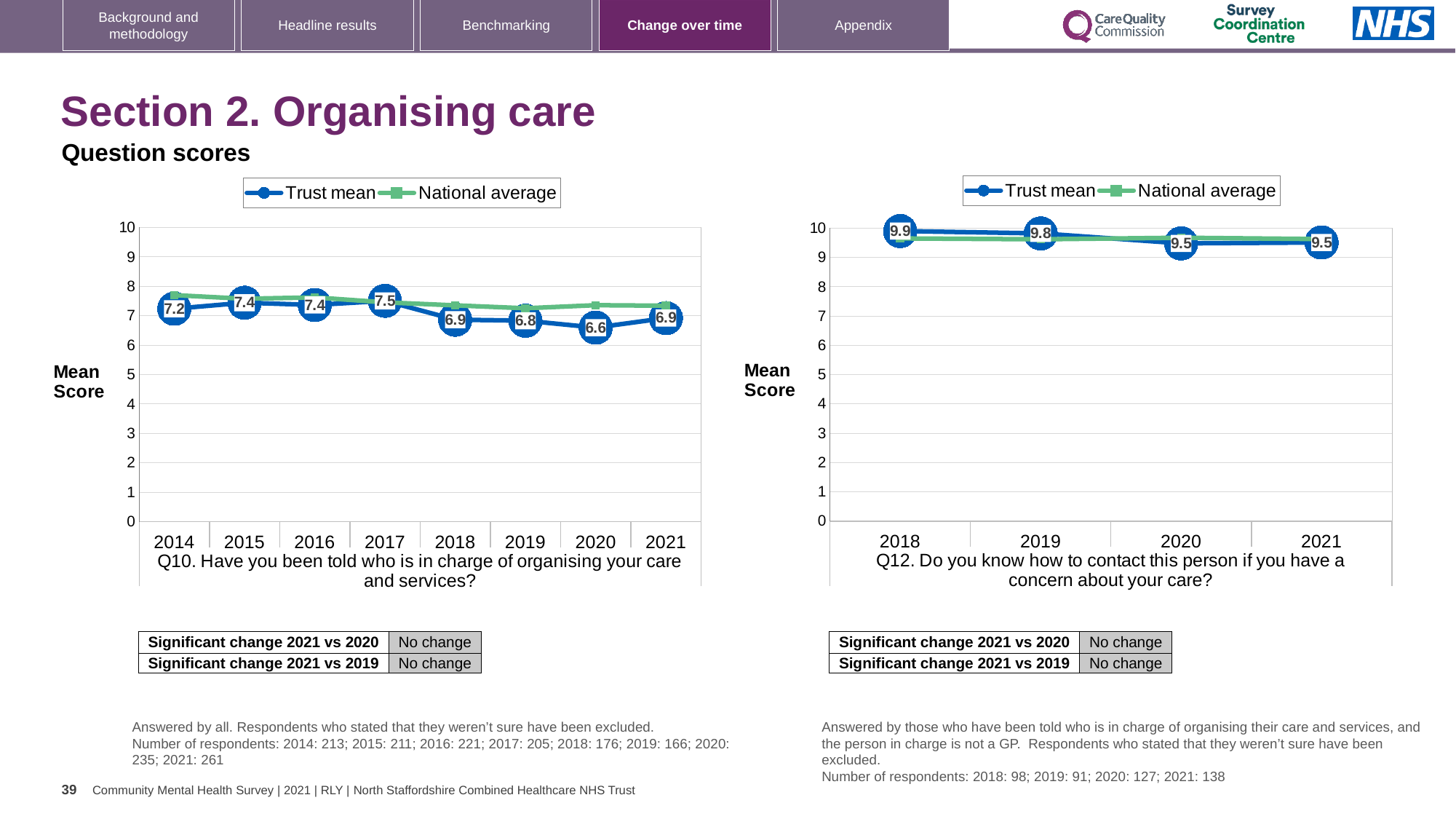
In the Q12 chart on the right, what is the Trust mean for 2021? 9.5 In the Q10 chart on the left, what is the Trust mean for 2020? 6.6 In the Q12 chart on the right, what is the Trust mean for 2018? 9.9 In the Q12 chart on the right, is the Trust mean for 2019 larger or smaller than the Trust mean for 2020? larger In the Q10 chart on the left, what is the Trust mean for 2017? 7.5 What kind of chart is the Q10 chart on the left? line chart In the Q12 chart on the right, does the Trust mean rise or fall from 2018 to 2021? fall In the Q10 chart on the left, which year has the highest Trust mean? 2017 How many series does the legend of the Q12 chart on the right list? 2 In the Q10 chart on the left, what is the difference between the Trust mean in 2017 and in 2020? 0.9 In the Q10 chart on the left, which year has the lowest Trust mean? 2020 In the Q10 chart on the left, how many years are shown on the x axis? 8